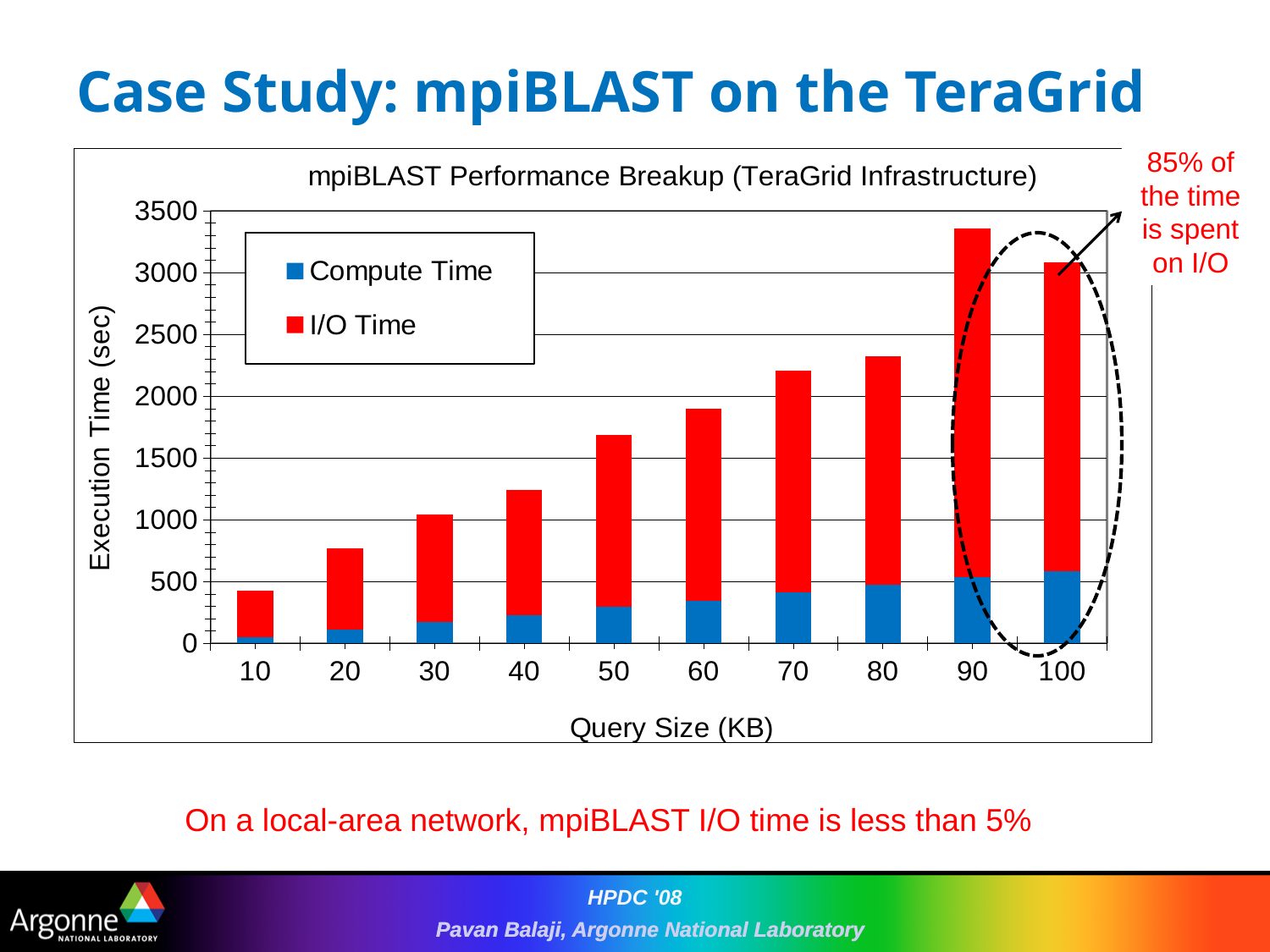
Which colour represents I/O Time in the chart? Red What is the title of the chart? mpiBLAST Performance Breakup (TeraGrid Infrastructure) Which query size has the lowest total execution time? 10 How many query sizes are plotted along the x axis? 10 Which has the larger total execution time, query size 90 or query size 100? 90 Is the total execution time for query size 10 greater or less than 500? less Is the total execution time for query size 90 greater or less than 3000? greater Which query size has the highest total execution time? 90 Is the total execution time for query size 70 greater or less than 2000? greater What kind of chart is shown on the slide? Stacked bar chart Do the total execution times generally rise or fall as query size increases from 10 to 90? rise How many series does the chart's legend list? 2